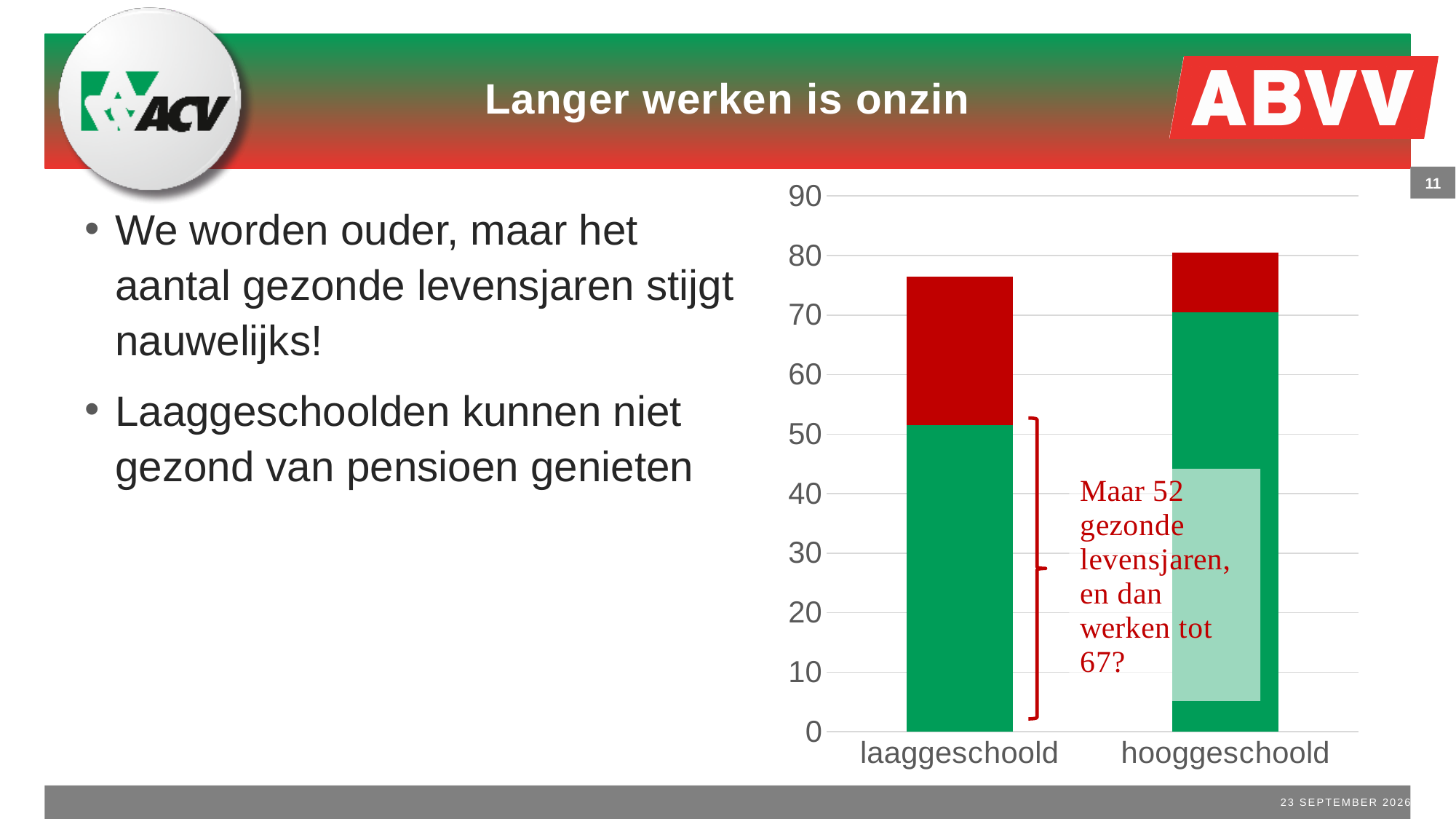
Is the green segment of the laaggeschoold bar greater or less than 60? less Which category has the larger red segment, laaggeschoold or hooggeschoold? laaggeschoold Which category has the larger green segment, laaggeschoold or hooggeschoold? hooggeschoold Is the total height of the laaggeschoold bar greater or less than 70? greater Is the total height of the laaggeschoold bar greater or less than 80? less What is the highest value shown on the y axis of the chart? 90 What kind of chart is shown on the slide? bar chart According to the annotation on the chart, how many healthy life years (gezonde levensjaren) are indicated for laaggeschoold? 52 What are the two categories on the x axis of the chart? laaggeschoold and hooggeschoold Which category has the taller stacked bar overall? hooggeschoold How many categories are shown on the x axis of the chart? 2